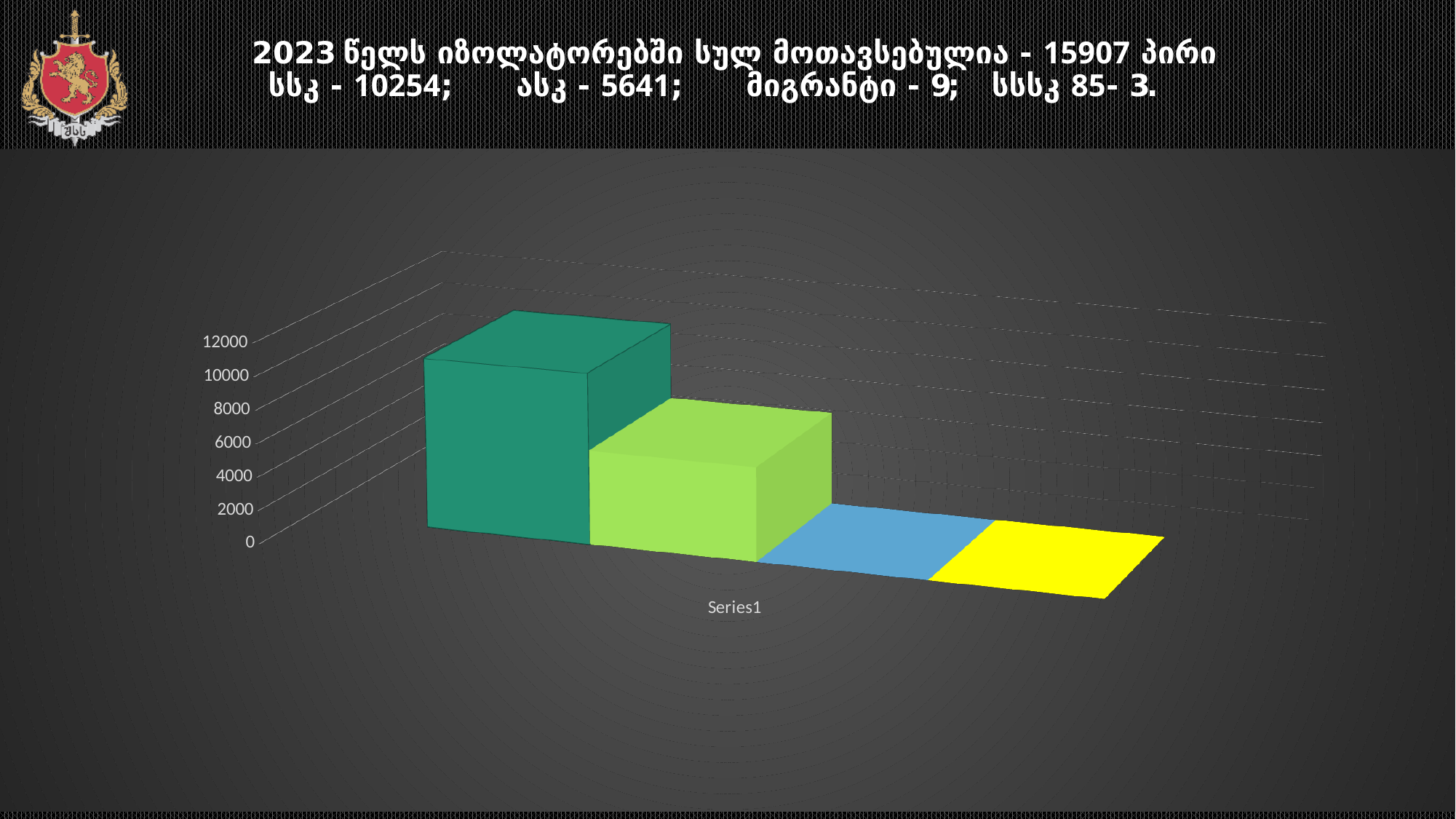
What is the highest tick value shown on the vertical axis? 12000 How many bars are plotted in the chart? 4 What label is shown on the horizontal axis of the chart? Series1 What kind of chart is shown on the slide? bar chart Do the bar values rise or fall from left to right along the x axis? fall Which bar is the tallest in the chart? the first (dark green) bar Is the value of the second (light green) bar greater or less than 4000? greater Is the value of the first (dark green) bar greater or less than 12000? less Is the value of the first (dark green) bar greater or less than 10000? greater Which is larger, the first (dark green) bar or the second (light green) bar? the first (dark green) bar